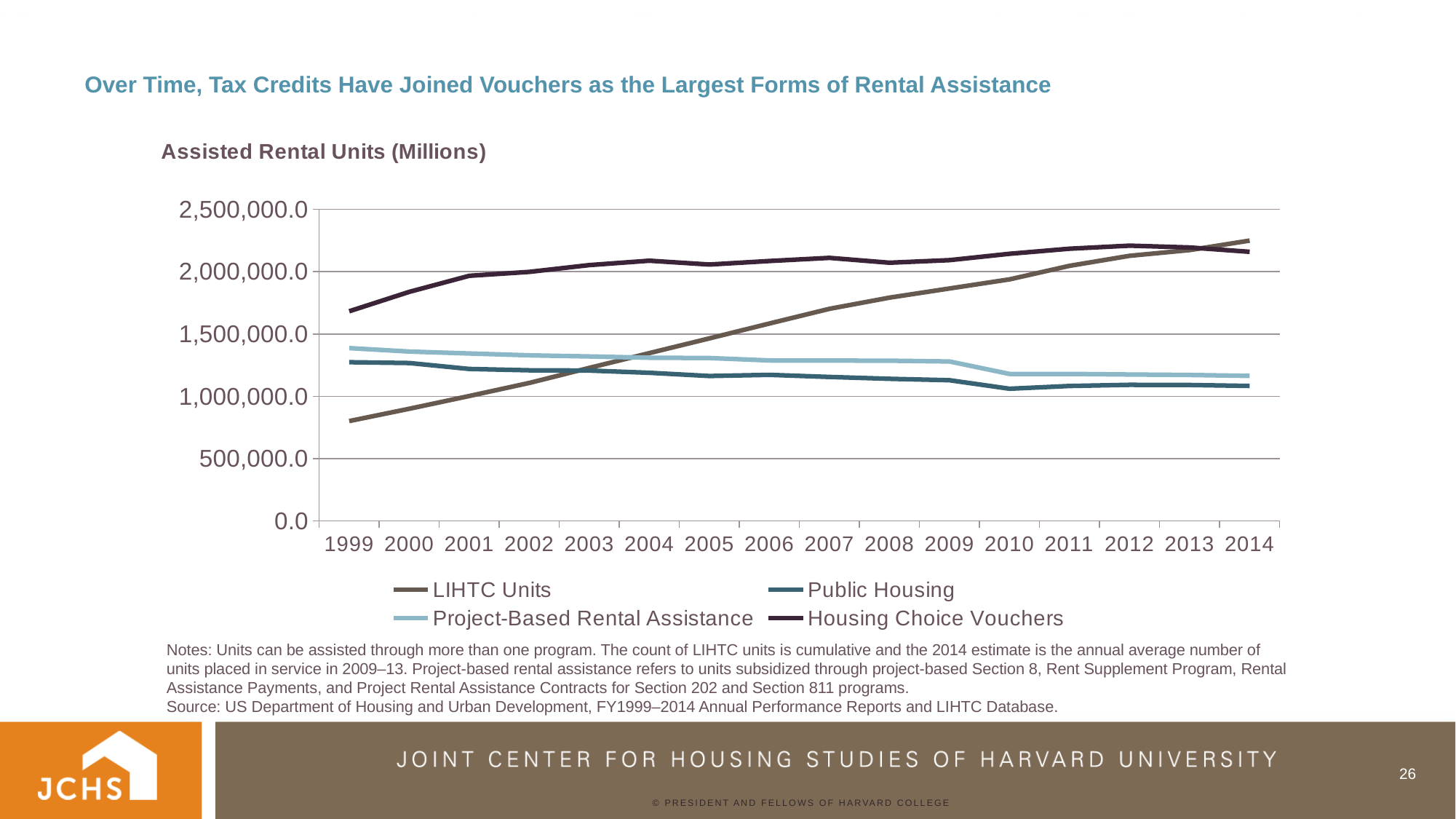
What kind of chart is shown on the slide? line chart Is the value for Project-Based Rental Assistance in 2010 greater or less than 1,500,000.0? less In 2005, which is larger: Housing Choice Vouchers or LIHTC Units? Housing Choice Vouchers Do the values for LIHTC Units rise or fall from 1999 to 2014? rise How many years are shown on the x axis? 16 Is the value for LIHTC Units in 1999 greater or less than 1,000,000.0? less Do the values for Public Housing rise or fall from 1999 to 2014? fall Is the value for Housing Choice Vouchers in 2014 greater or less than 2,000,000.0? greater What is the title of the chart? Assisted Rental Units (Millions) How many series does the legend list? 4 Which series has the highest value in 1999? Housing Choice Vouchers Which series has the lowest value in 2014? Public Housing